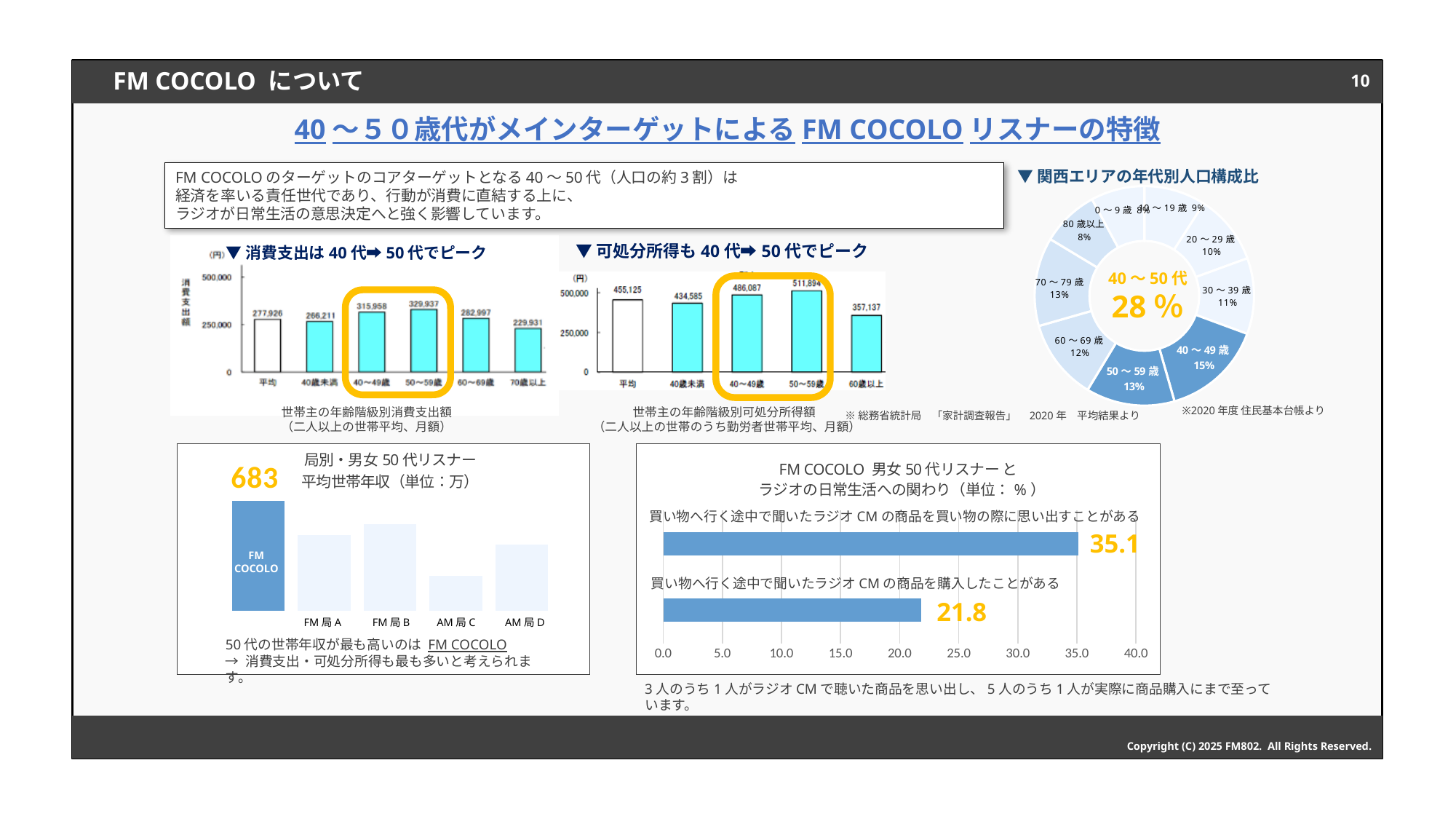
In the disposable income chart (可処分所得も40代➡50代でピーク), which age group has the highest value? 50～59歳 In the FM COCOLO 50代 listener radio involvement chart, what is the value for 買い物へ行く途中で聞いたラジオCMの商品を購入したことがある? 21.8 In the Kansai area population donut chart (関西エリアの年代別人口構成比), which is larger, 60～69歳 or 30～39歳? 60～69歳 In the disposable income chart (可処分所得も40代➡50代でピーク), how many bars are shown? 5 In the disposable income chart (可処分所得も40代➡50代でピーク), what is the value for 40～49歳? 486,087 In the consumption expenditure chart (消費支出は40代➡50代でピーク), which age group has the lowest value? 70歳以上 In the Kansai area population donut chart (関西エリアの年代別人口構成比), what percentage is shown in the center for 40～50代? 28％ In the consumption expenditure chart (消費支出は40代➡50代でピーク), what is the difference between 50～59歳 and 40～49歳? 13,979 What type of chart is the FM COCOLO 50代 listener radio involvement chart (ラジオの日常生活への関わり)? Bar chart In the Kansai area population donut chart (関西エリアの年代別人口構成比), what share is 40～49歳? 15% In the chart of 50代 listener average household income by station (局別・男女50代リスナー平均世帯年収), what is the value for FM COCOLO? 683 In the consumption expenditure chart (消費支出は40代➡50代でピーク), what is the value for 50～59歳? 329,937